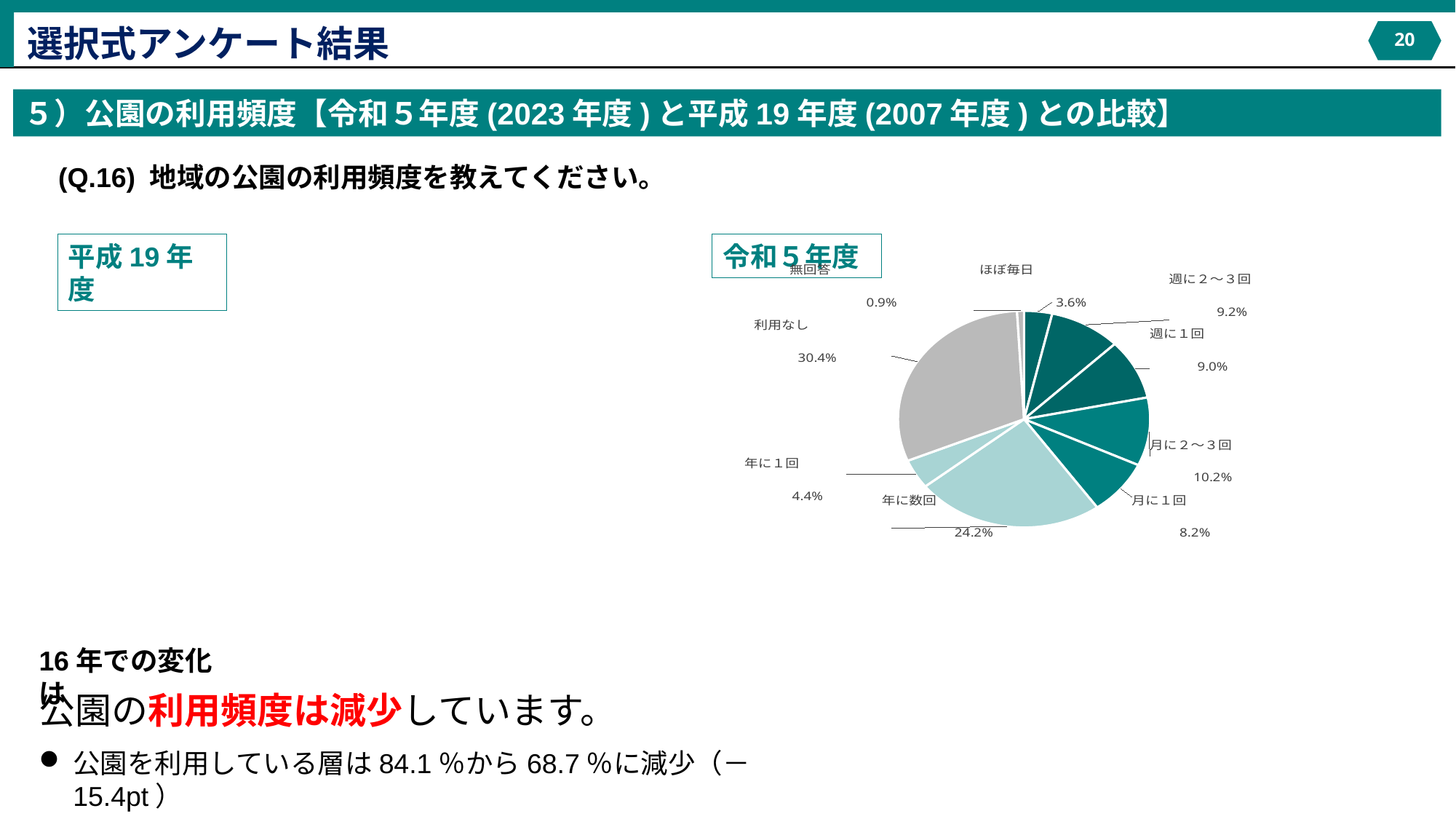
What type of chart is used to show the 令和５年度 data? Pie chart In the 令和５年度 pie chart, what share of the pie does 年に１回 represent? 4.4% In the 令和５年度 pie chart, what percentage is shown for 利用なし? 30.4% In the 令和５年度 pie chart, what is the difference in percentage points between 利用なし and 年に数回? 6.2 In the 令和５年度 pie chart, which category has the smallest share? 無回答 In the 令和５年度 pie chart, what percentage is shown for 月に２〜３回? 10.2% In the 令和５年度 pie chart, which category has the largest share? 利用なし In the 令和５年度 pie chart, what percentage is shown for 年に数回? 24.2% How many categories (slices) does the 令和５年度 pie chart have? 9 In the 令和５年度 pie chart, which is larger: 週に２〜３回 or 月に１回? 週に２〜３回 In the 令和５年度 pie chart, what colour is the 利用なし slice? Grey In the 令和５年度 pie chart, what percentage is shown for ほぼ毎日? 3.6%